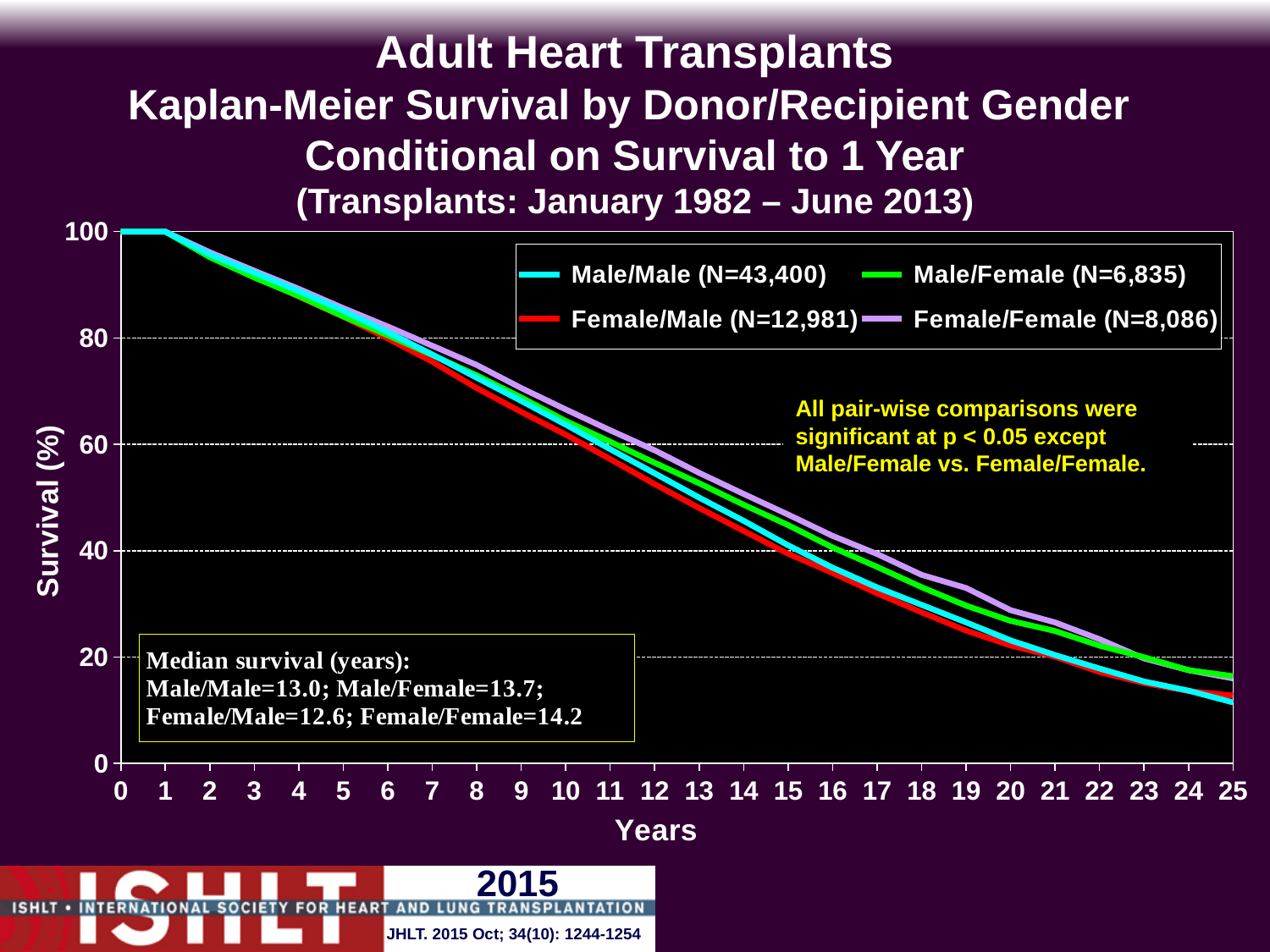
Is the survival value for the Female/Female curve at 10 years greater or less than 60? greater Which group has the highest median survival? Female/Female Which has the larger median survival, Male/Female or Female/Male? Male/Female What is the difference in median survival between Female/Female and Male/Male? 1.2 years What is the median survival in years for the Female/Female group? 14.2 What kind of chart is shown on the slide? line chart Which donor/recipient gender group has the largest N in the legend? Male/Male (N=43,400) What is the median survival in years for the Male/Male group? 13.0 What is the N for the Female/Female group shown in the legend? 8,086 How many series does the legend list? 4 Do the survival curves rise or fall as years increase? fall Which group has the lowest median survival? Female/Male